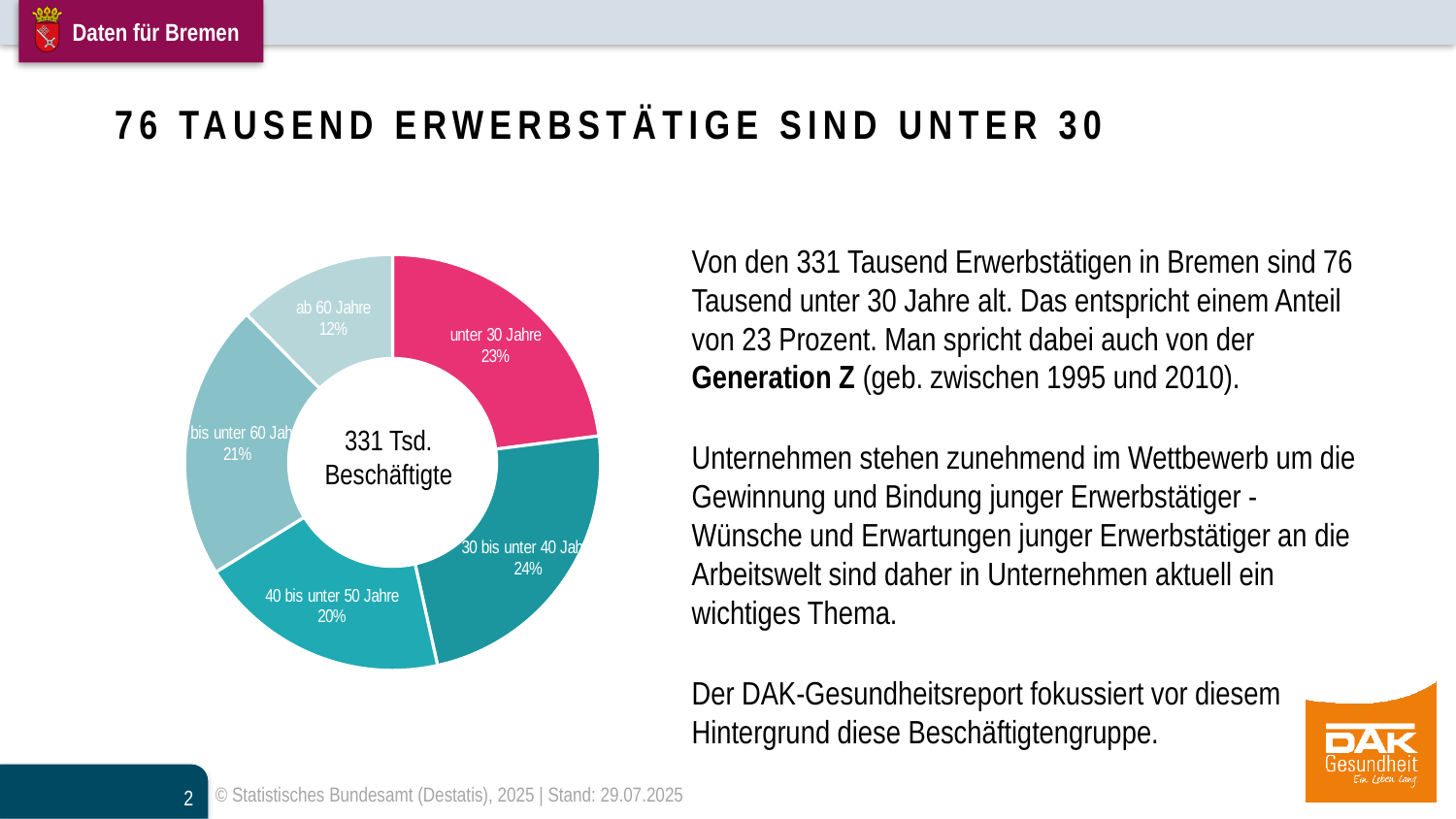
Which age group has the smallest share in the chart? ab 60 Jahre How many percentage points larger is the "unter 30 Jahre" share than the "ab 60 Jahre" share? 11 percentage points Which segment is larger: "40 bis unter 50 Jahre" or "50 bis unter 60 Jahre"? 50 bis unter 60 Jahre What text is shown in the centre of the donut chart? 331 Tsd. Beschäftigte Which age group has the largest share in the chart? 30 bis unter 40 Jahre What colour is the "unter 30 Jahre" segment? pink/magenta What kind of chart is shown on the slide? pie chart (donut) What share of the chart is labelled "unter 30 Jahre"? 23% What percentage is shown for the "30 bis unter 40 Jahre" segment? 24% What percentage is shown for the "40 bis unter 50 Jahre" segment? 20% How many age-group segments does the chart have? 5 What percentage is shown for the "ab 60 Jahre" segment? 12%